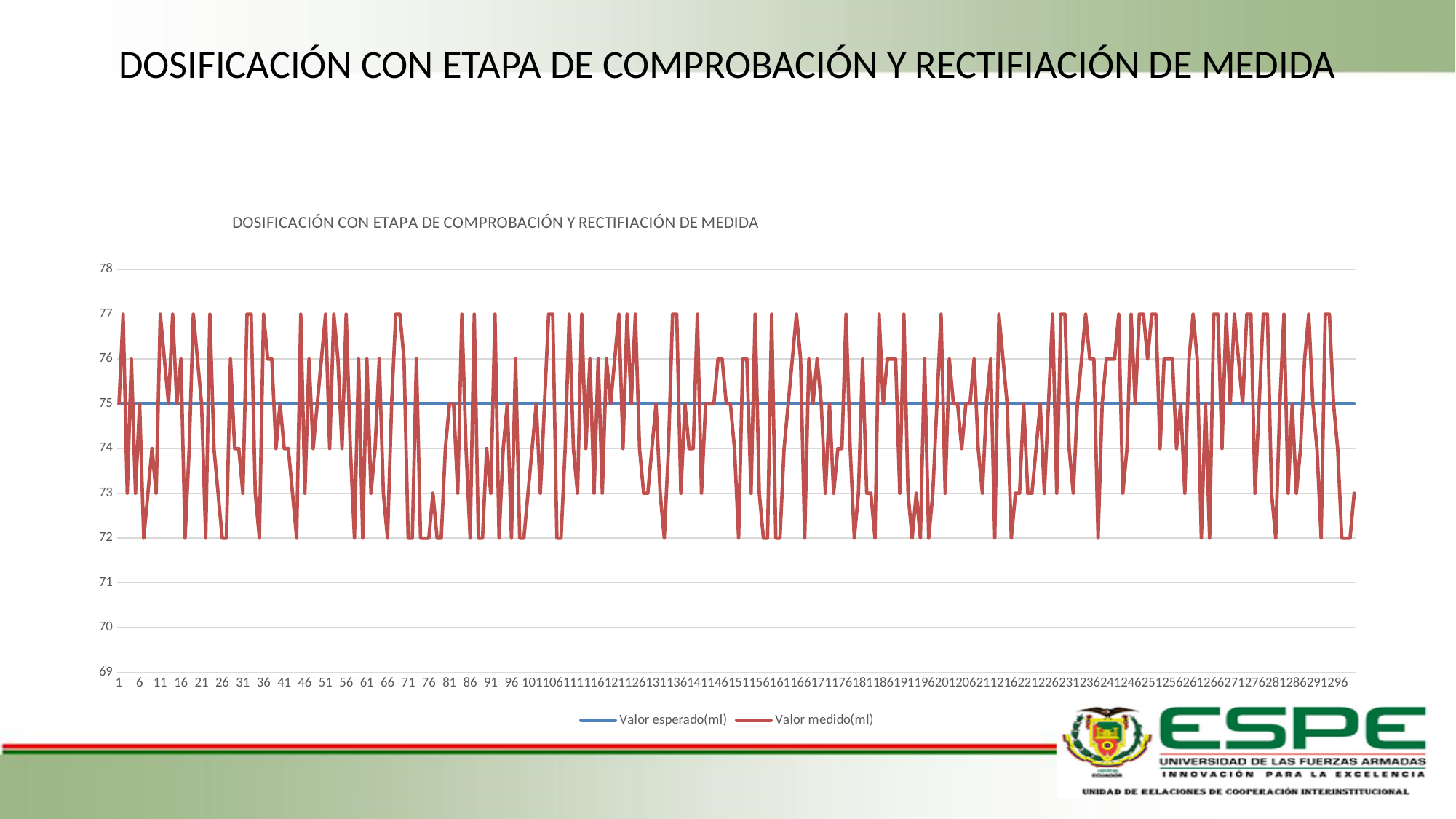
What constant value does the Valor esperado(ml) line sit at? 75 Is the value of Valor esperado(ml) greater or less than 74? greater How many series does the legend list? 2 What is the highest value reached by the Valor medido(ml) series? 77 Is the value of Valor esperado(ml) greater or less than 76? less What kind of chart is shown on the slide? Line chart Does the Valor esperado(ml) line rise, fall, or stay flat along the x axis? Stays flat What is the lowest value reached by the Valor medido(ml) series? 72 What are the two series named in the legend? Valor esperado(ml) and Valor medido(ml) What is the title of the chart? DOSIFICACIÓN CON ETAPA DE COMPROBACIÓN Y RECTIFIACIÓN DE MEDIDA Is the highest value of Valor medido(ml) greater or less than 78? less At x = 1, which series has the higher value, Valor esperado(ml) or Valor medido(ml)? Neither; both are 75